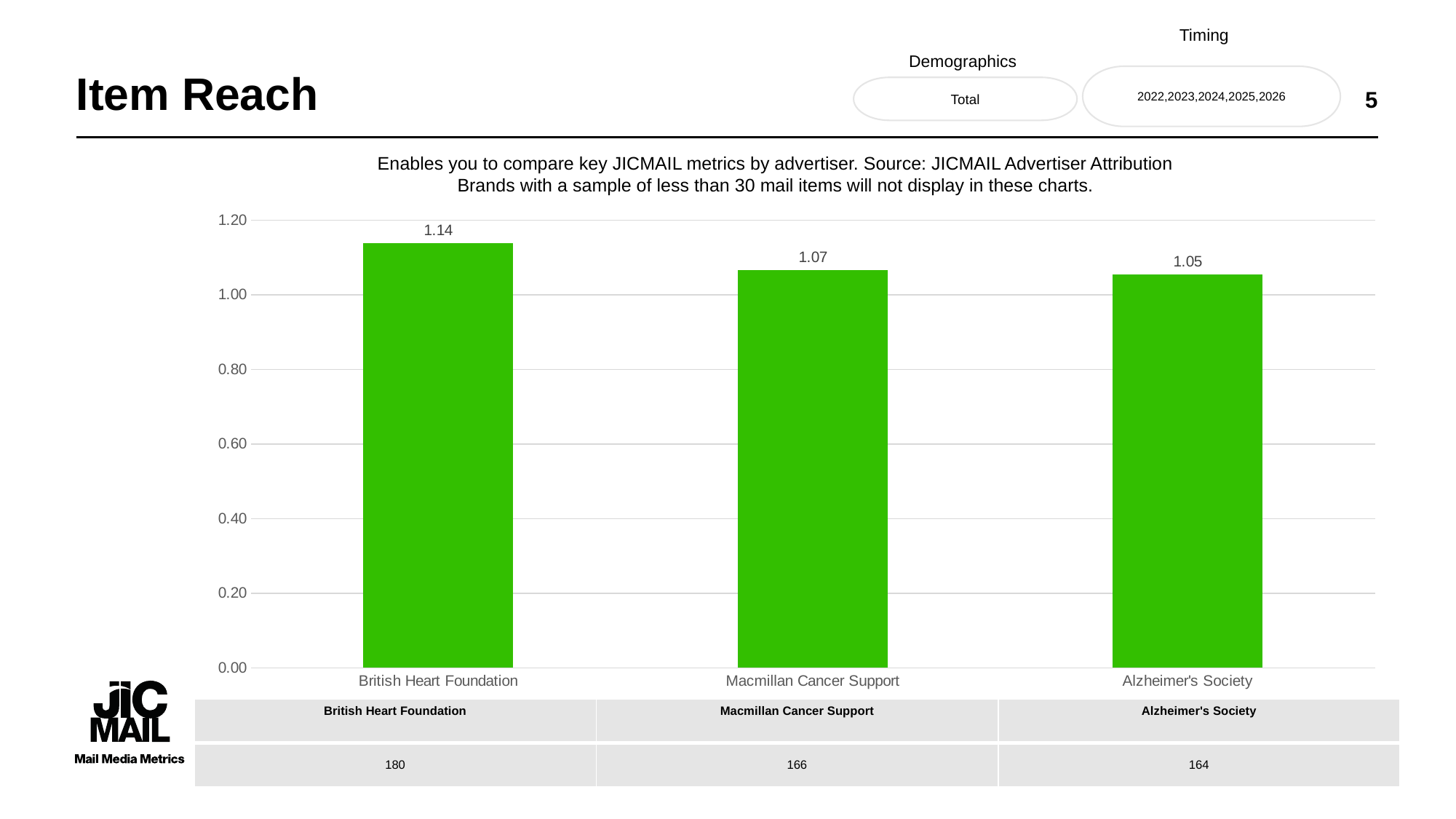
What kind of chart is shown on the slide? Bar chart Which advertiser has the highest Item Reach? British Heart Foundation Which has a higher Item Reach, British Heart Foundation or Macmillan Cancer Support? British Heart Foundation Is the Item Reach value for Alzheimer's Society greater or less than 1.00? greater What is the Item Reach value for Macmillan Cancer Support? 1.07 What is the Item Reach value for British Heart Foundation? 1.14 What is the difference in Item Reach between British Heart Foundation and Alzheimer's Society? 0.09 What is the Item Reach value for Alzheimer's Society? 1.05 Which advertiser has the lowest Item Reach? Alzheimer's Society How many advertisers are shown in the chart? 3 Do the Item Reach values rise or fall from left to right across the advertisers? Fall What is the difference in Item Reach between British Heart Foundation and Macmillan Cancer Support? 0.07